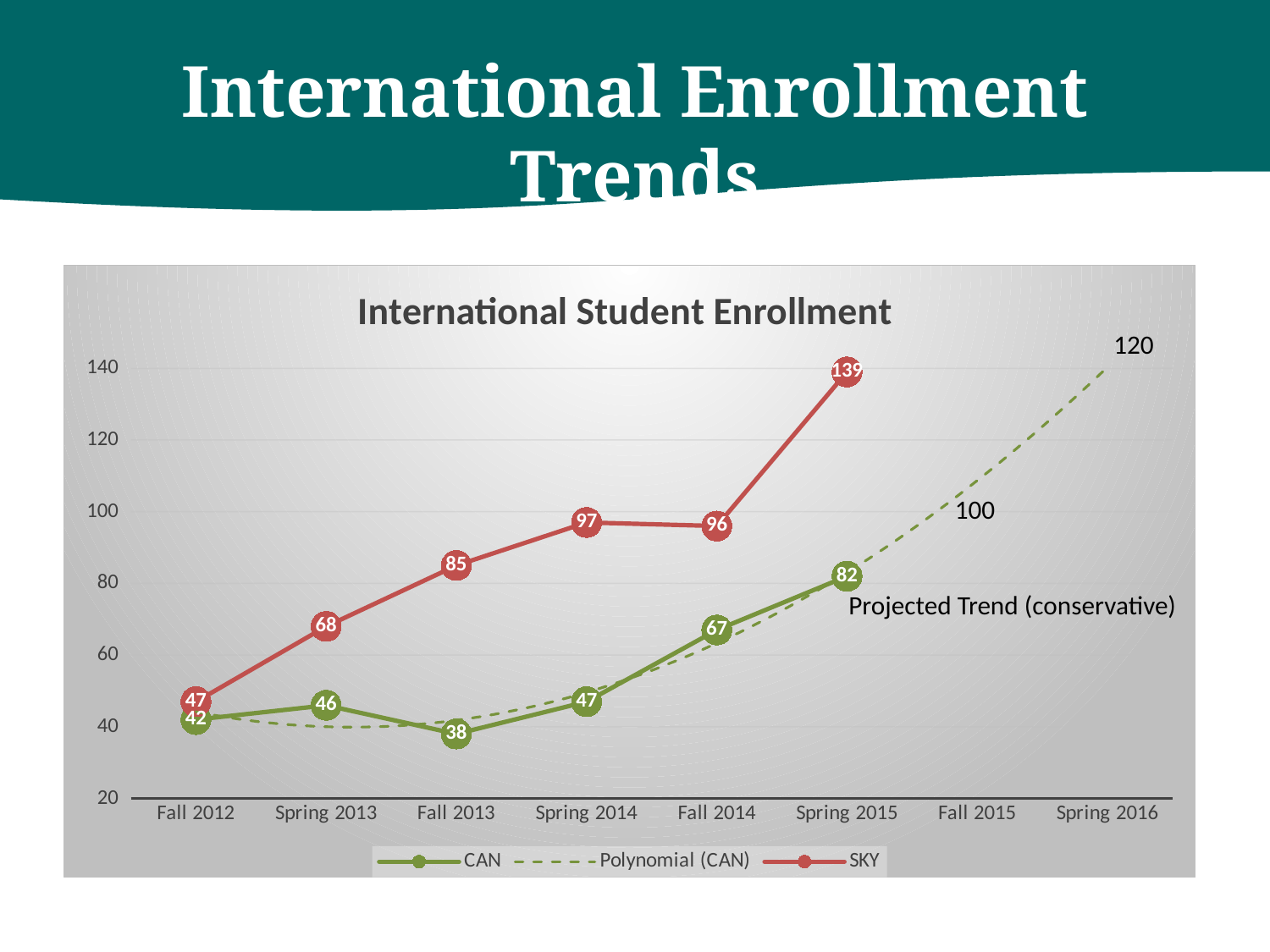
In which period is the CAN series at its lowest? Fall 2013 Which is larger in Spring 2014, the SKY value or the CAN value? SKY What is the SKY value for Fall 2013? 85 What is the CAN value for Fall 2014? 67 How many series does the legend list? 3 What is the CAN value for Fall 2013? 38 Does the SKY series generally rise or fall from Fall 2012 to Spring 2015? Rise What is the SKY value for Spring 2015? 139 What kind of chart is shown on the slide? Line chart What is the difference between the SKY and CAN values in Spring 2015? 57 What is the title of the chart? International Student Enrollment In which period is the SKY series at its highest? Spring 2015